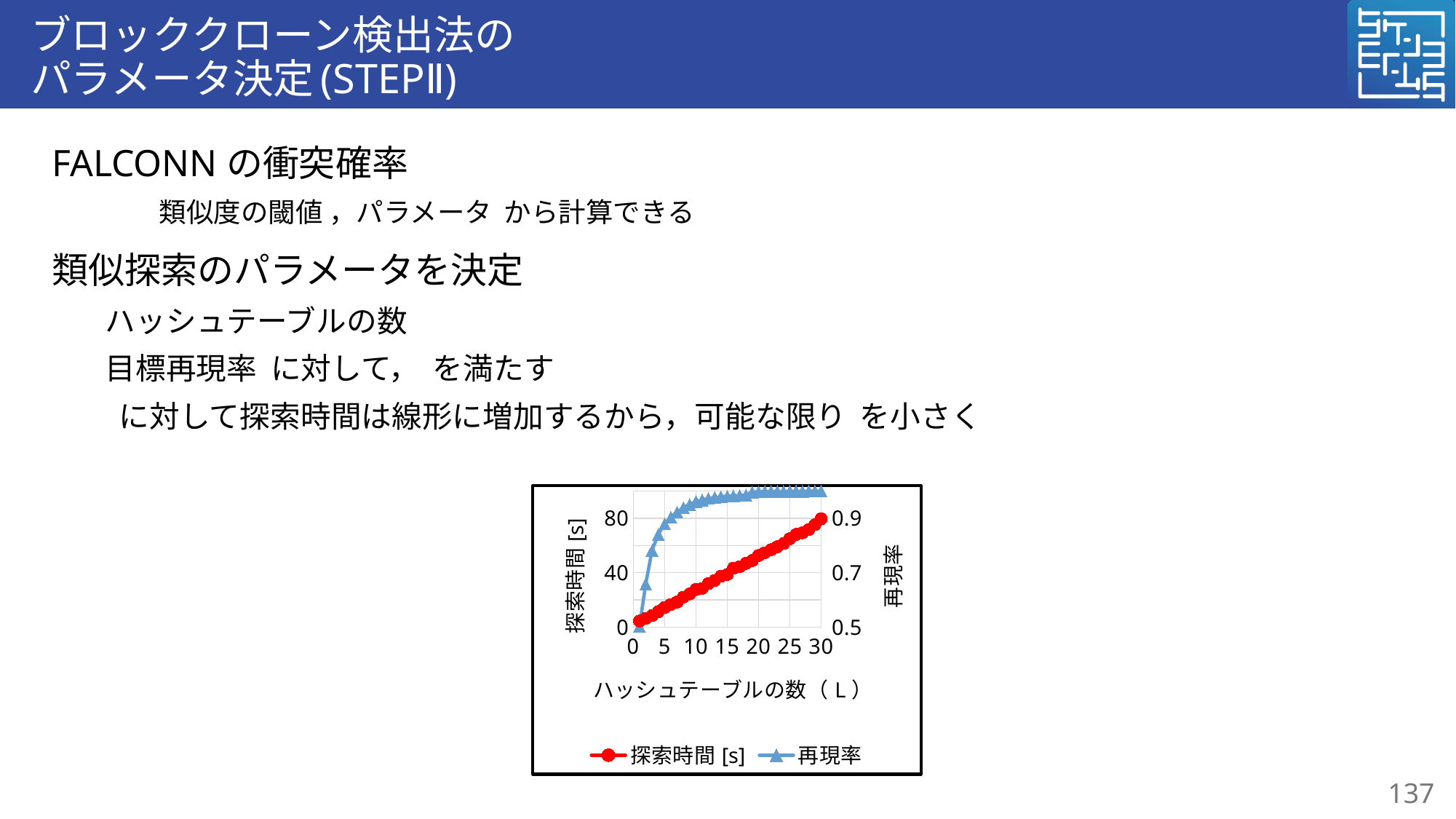
Is the value of 再現率 at L = 30 greater or less than 0.9? greater What kind of chart is shown on the slide? line chart Is the value of 探索時間 [s] at L = 5 greater or less than 40? less Is the value of 探索時間 [s] at L = 10 greater or less than 40? less How many series does the chart's legend list? 2 What is the title of the chart's x axis? ハッシュテーブルの数（L） Does the 探索時間 [s] series rise or fall as the number of hash tables (L) increases? rise What are the two series listed in the chart's legend? 探索時間 [s] and 再現率 Does the 再現率 series rise or fall as the number of hash tables (L) increases? rise